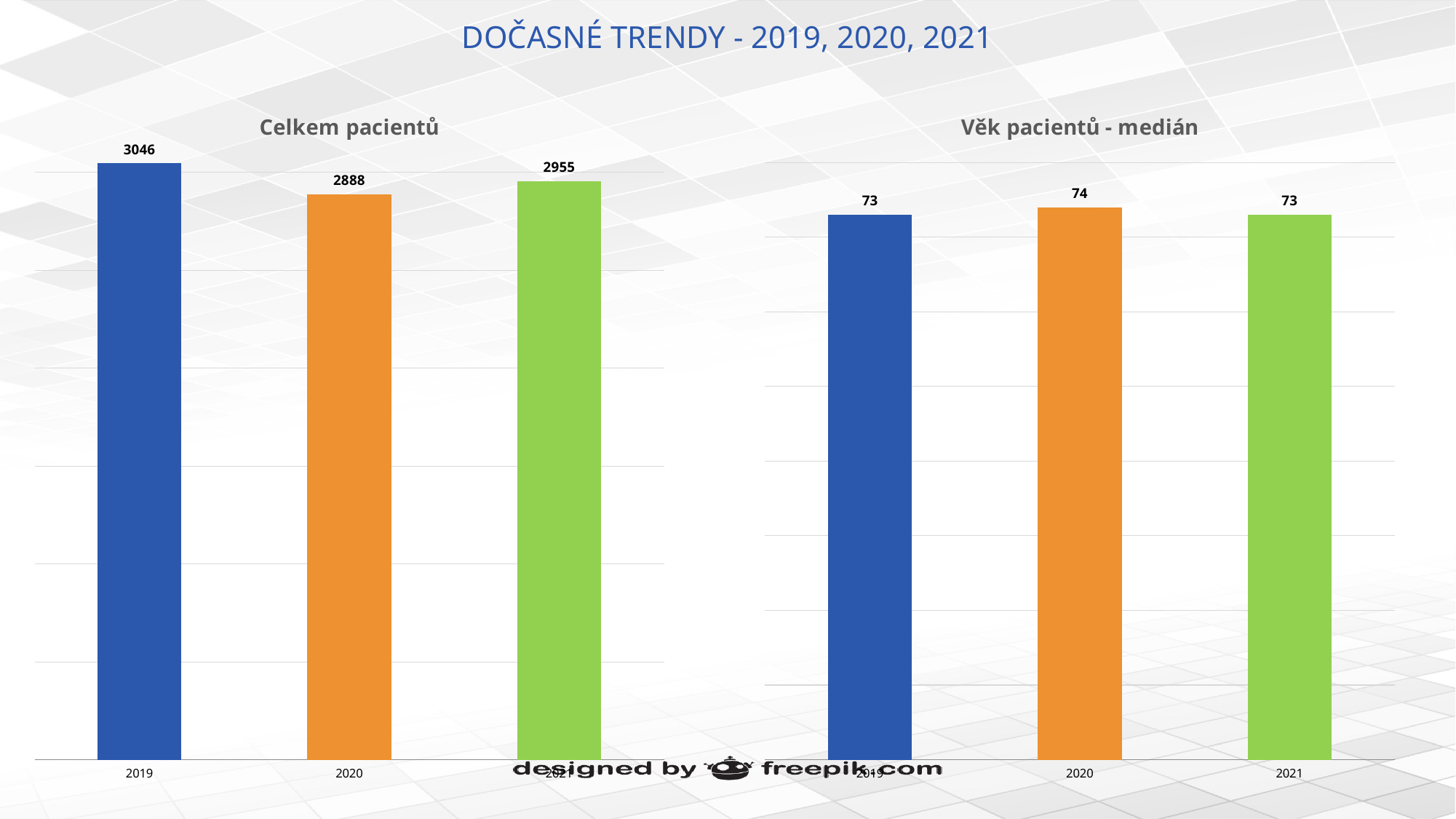
How many categories does the 'Celkem pacientů' chart show? 3 In the 'Věk pacientů - medián' chart, what is the difference between the values for 2020 and 2019? 1 In the 'Věk pacientů - medián' chart, what is the value for 2020? 74 In the 'Celkem pacientů' chart, which is larger, the value for 2020 or the value for 2021? 2021 In the 'Celkem pacientů' chart, what is the difference between the values for 2019 and 2021? 91 What kind of chart is the 'Věk pacientů - medián' chart? bar chart What is the title of the chart on the right side of the slide? Věk pacientů - medián In the 'Celkem pacientů' chart, which year has the lowest value? 2020 In the 'Věk pacientů - medián' chart, what is the value for 2021? 73 In the 'Celkem pacientů' chart, which year has the highest value? 2019 In the 'Celkem pacientů' chart, what is the value for 2020? 2888 In the 'Celkem pacientů' chart, what is the value for 2019? 3046